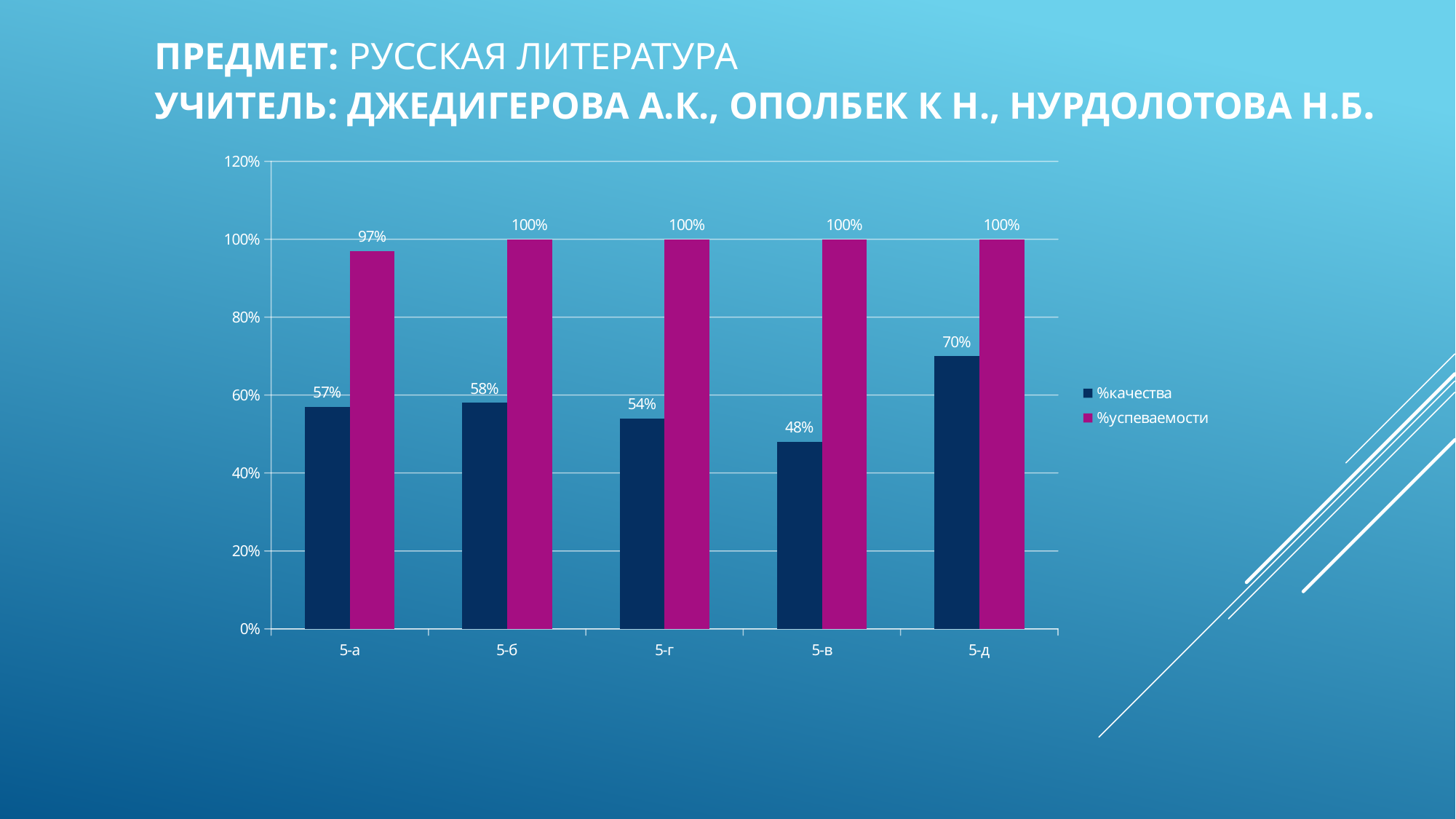
Which class has the highest %качества value? 5-д What is the %успеваемости value for class 5-а? 97% How many classes are shown on the x axis? 5 How many series does the legend list? 2 What is the difference between the %качества values for 5-д and 5-в? 22% What is the %качества value for class 5-в? 48% What colour are the %успеваемости bars? magenta Which is larger, the %качества value for 5-б or for 5-г? 5-б What kind of chart is shown on the slide? bar chart Which class has the lowest %качества value? 5-в Which class has the lowest %успеваемости value? 5-а What is the %качества value for class 5-д? 70%